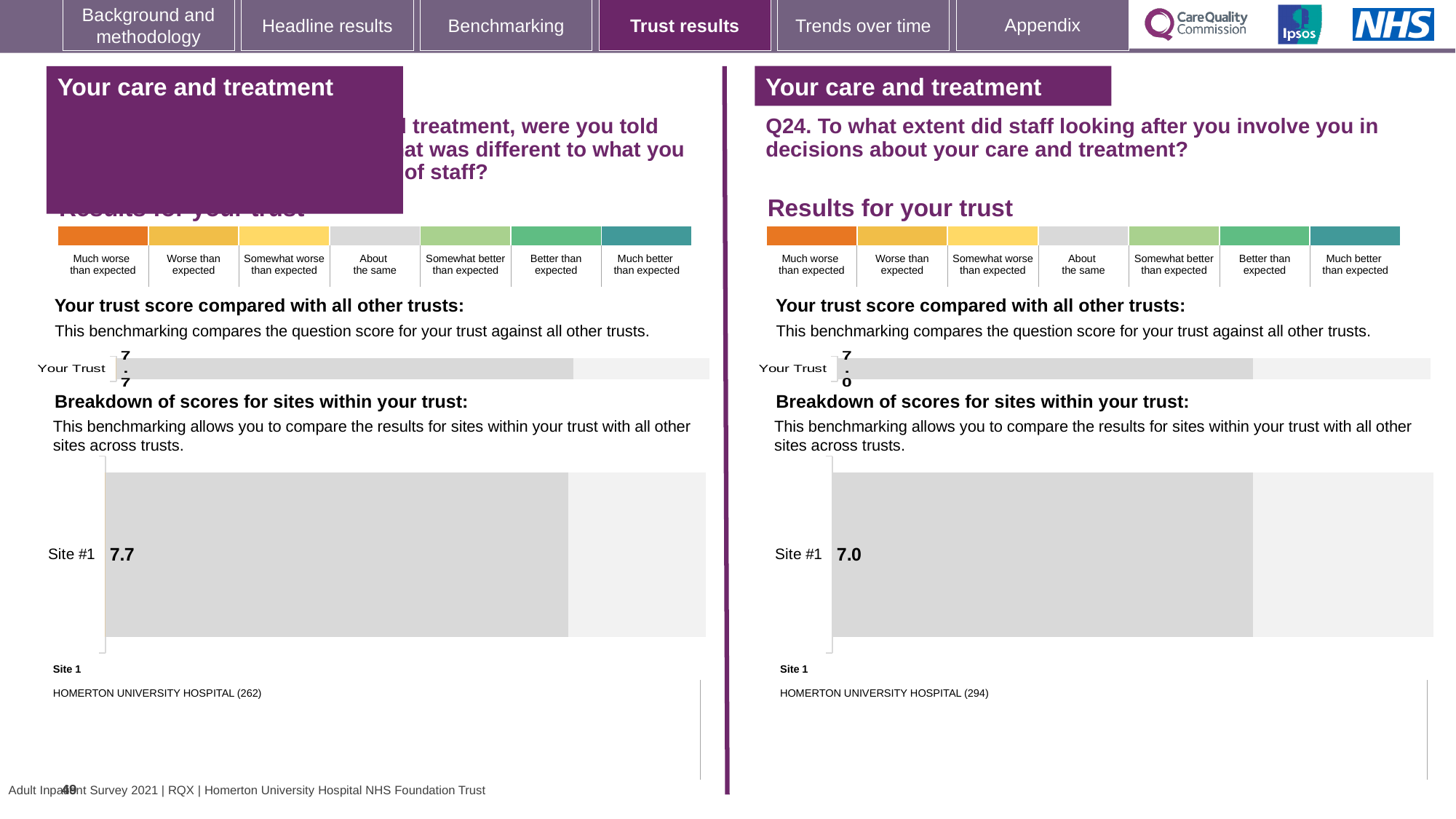
On the left half of the slide, which site is listed as Site 1 below the chart? HOMERTON UNIVERSITY HOSPITAL (262) What is the difference between the Site #1 score on the left half of the slide and the Site #1 score on the right half (Q24)? 0.7 On the left half of the slide, what is the score shown for Site #1 in the 'Breakdown of scores for sites within your trust' chart? 7.7 On the left half of the slide, how many sites are shown in the 'Breakdown of scores for sites within your trust' chart? 1 On the left half of the slide, what is the score shown for Your Trust in the 'Your trust score compared with all other trusts' chart? 7.7 On the right half of the slide (Q24), how many sites are shown in the 'Breakdown of scores for sites within your trust' chart? 1 On the right half of the slide (Q24), which site is listed as Site 1 below the chart? HOMERTON UNIVERSITY HOSPITAL (294) On the right half of the slide (Q24), what is the score shown for Your Trust in the 'Your trust score compared with all other trusts' chart? 7.0 On the right half of the slide (Q24), what is the score shown for Site #1 in the 'Breakdown of scores for sites within your trust' chart? 7.0 What kind of chart is used to show the Site #1 score on the right half of the slide (Q24)? Bar chart On the right half of the slide (Q24), is the Site #1 score greater or less than the Your Trust score on the left half of the slide? less Which is larger: the Your Trust score on the left half of the slide or the Your Trust score on the right half (Q24)? Left half (7.7)